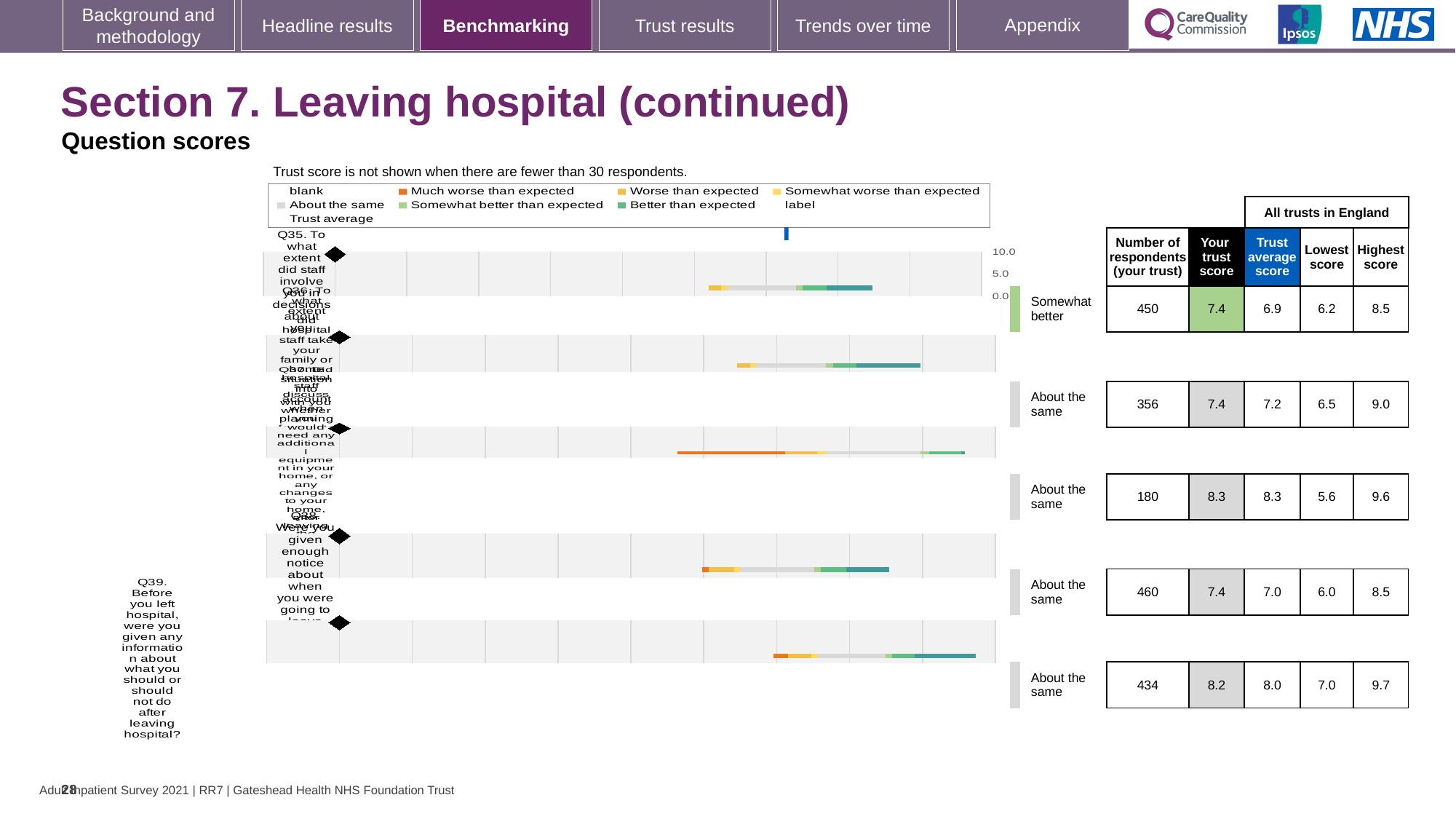
Which question has the largest number of respondents from your trust? Q38 (460) What is your trust score for Q39 (were you given any information about what you should or should not do after leaving hospital)? 8.2 Is your trust score for Q39 greater or less than 5.0 on the chart axis? greater What is the difference between your trust score and the trust average score for Q38? 0.4 Which question has the highest 'Highest score' value in the table? Q39 (9.7) For Q35, which is larger: your trust score or the trust average score? Your trust score (7.4) What is the highest score across all trusts in England for Q36? 9.0 What colour represents 'Much worse than expected' in the chart legend? Orange What benchmark category is shown for Q35? Somewhat better How many questions are plotted in the benchmarking chart? 5 What kind of chart is used to show the question scores? Bar chart How many respondents from your trust answered Q35 (to what extent did staff involve you in decisions about you leaving hospital)? 450